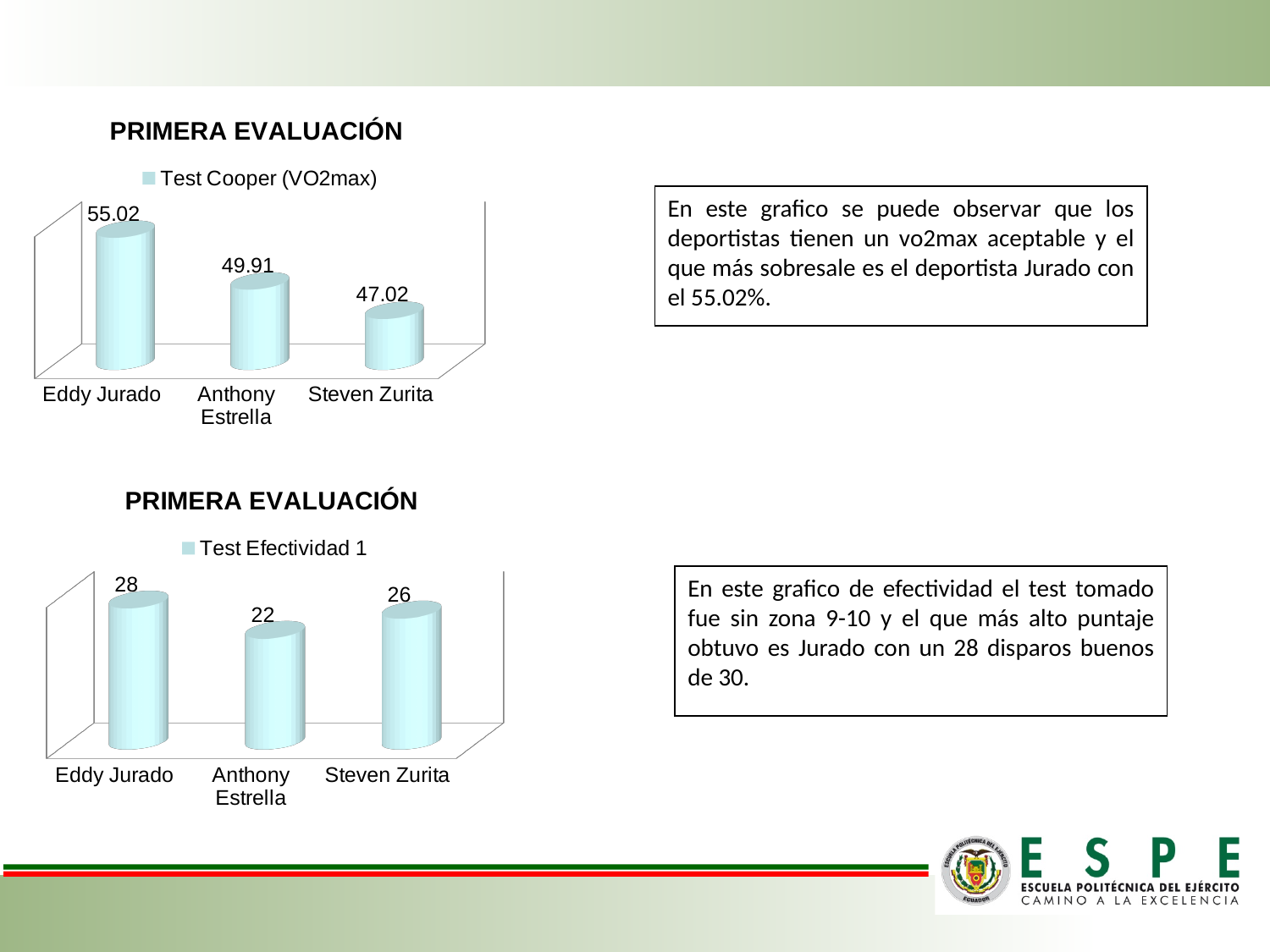
In the bottom chart (Test Efectividad 1), what is the value for Steven Zurita? 26 In the top chart (Test Cooper (VO2max)), which athlete has the lowest value? Steven Zurita In the bottom chart (Test Efectividad 1), which athlete has the lowest value? Anthony Estrella In the bottom chart (Test Efectividad 1), which athlete has the highest value? Eddy Jurado In the top chart (Test Cooper (VO2max)), what is the value for Eddy Jurado? 55.02 In the bottom chart (Test Efectividad 1), what is the difference between Eddy Jurado's and Anthony Estrella's values? 6 In the top chart (Test Cooper (VO2max)), what is the value for Anthony Estrella? 49.91 In the top chart (Test Cooper (VO2max)), what is the difference between Eddy Jurado's and Steven Zurita's values? 8.00 In the top chart (Test Cooper (VO2max)), how many athletes are shown? 3 What series name does the legend of the bottom chart show? Test Efectividad 1 What kind of chart is the top chart (Test Cooper (VO2max))? Bar chart In the bottom chart (Test Efectividad 1), who has the larger value, Anthony Estrella or Steven Zurita? Steven Zurita